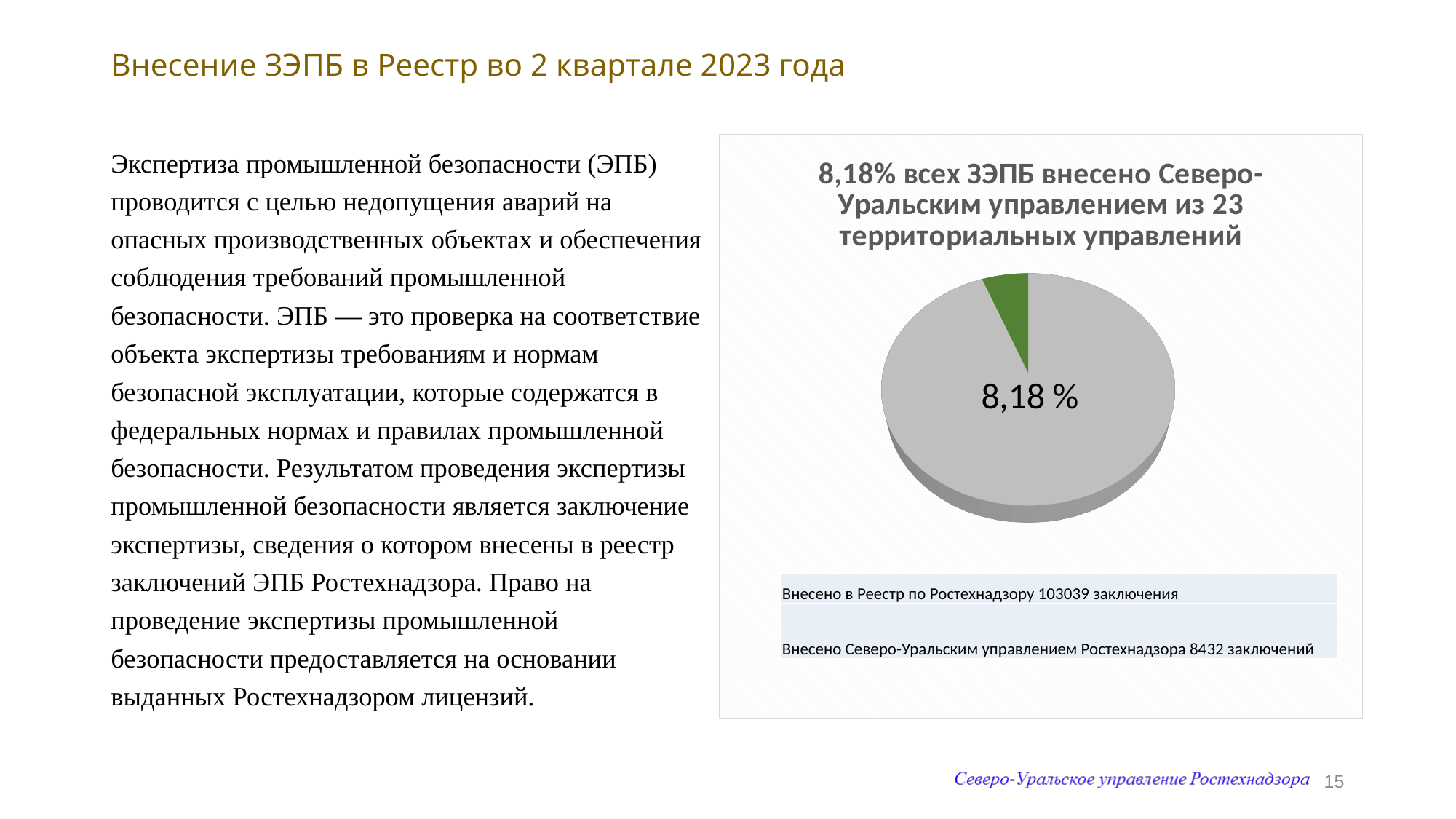
What share of the pie does the labelled slice represent? 8,18 % According to the text below the chart, how many заключений were entered into the Реестр по Ростехнадзору? 103039 What colour is the slice labelled 8,18 %? green How many slices does the pie chart have? 2 According to the text below the chart, how many заключений were entered by Северо-Уральское управление Ростехнадзора? 8432 According to the chart title, out of how many территориальных управлений is the Северо-Уральское управление's share shown? 23 What kind of chart is shown on the slide? pie chart What is the difference between the number of заключений entered по Ростехнадзору (103039) and the number entered by Северо-Уральское управление (8432)? 94607 Which slice of the pie is larger, the green slice or the grey slice? the grey slice Is the share of ЗЭПБ entered by Северо-Уральское управление greater or less than 10%? less